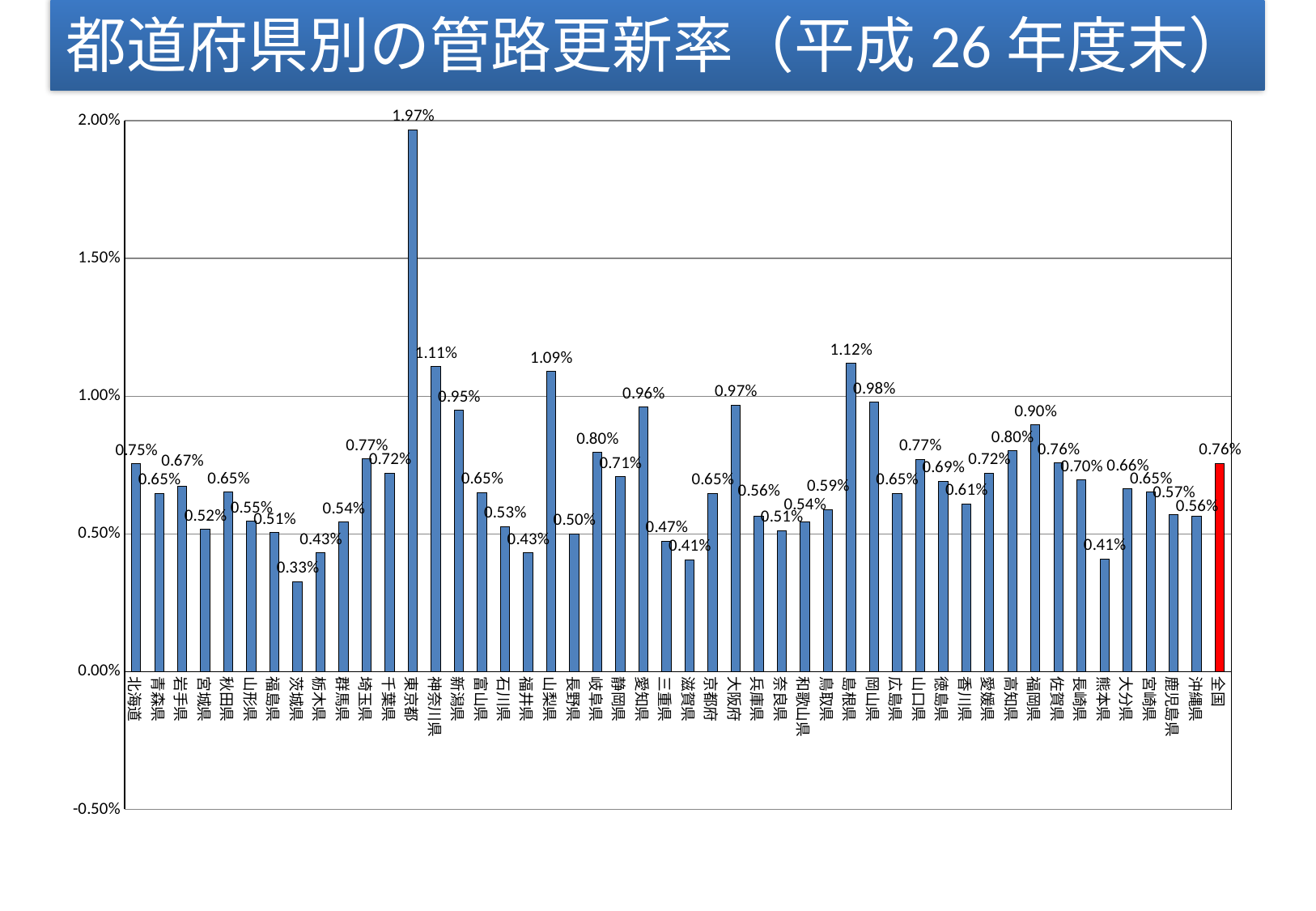
How many bars are plotted in the chart? 48 What is the value for 東京都? 1.97% Which category has the highest value? 東京都 What is the value for 全国? 0.76% What is the difference between the values for 東京都 and 神奈川県? 0.86% What is the value for 島根県? 1.12% What is the difference between the values for 全国 and 茨城県? 0.43% Which category has the lowest value? 茨城県 What type of chart is shown on the slide? bar chart Which is larger, the value for 山梨県 or the value for 大阪府? 山梨県 Is the value for 福岡県 greater or less than 1.00%? less What is the title of the chart on the slide? 都道府県別の管路更新率（平成26年度末）